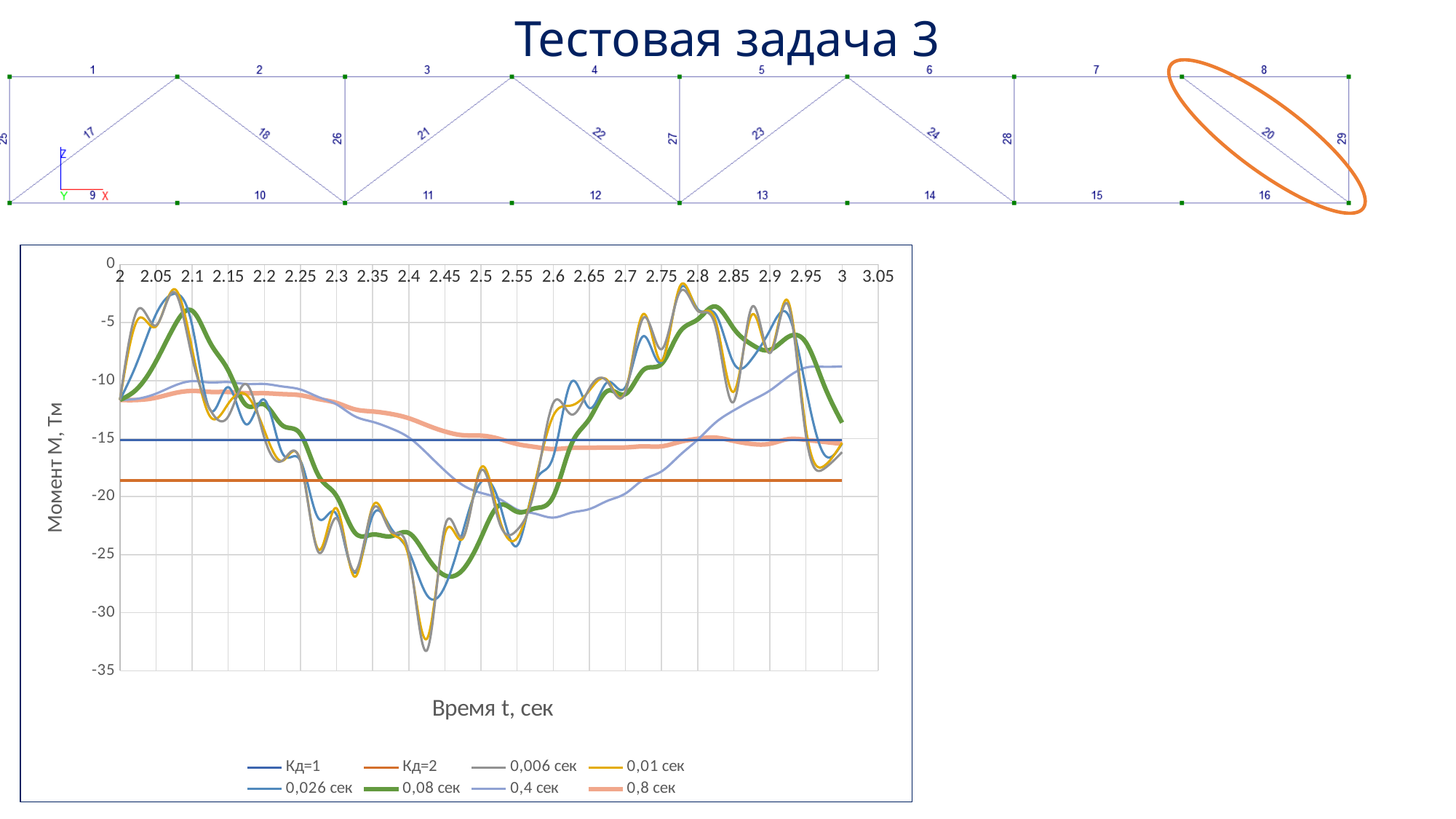
Is the value of the 0,4 сек series at t = 2.6 greater or less than -20? less Is the value of the 0,8 сек series at t = 2.2 greater or less than -15? greater At t = 2.45, which series has the higher value, 0,4 сек or 0,08 сек? 0,4 сек What is the title of the vertical axis of the chart? Момент М, Тм What is the title of the horizontal axis of the chart? Время t, сек What kind of chart is shown on the slide? line chart Which of the two horizontal lines, Кд=1 or Кд=2, lies higher on the chart? Кд=1 Is the lowest value reached by the 0,006 сек series greater or less than -30? less How many series does the chart legend list? 8